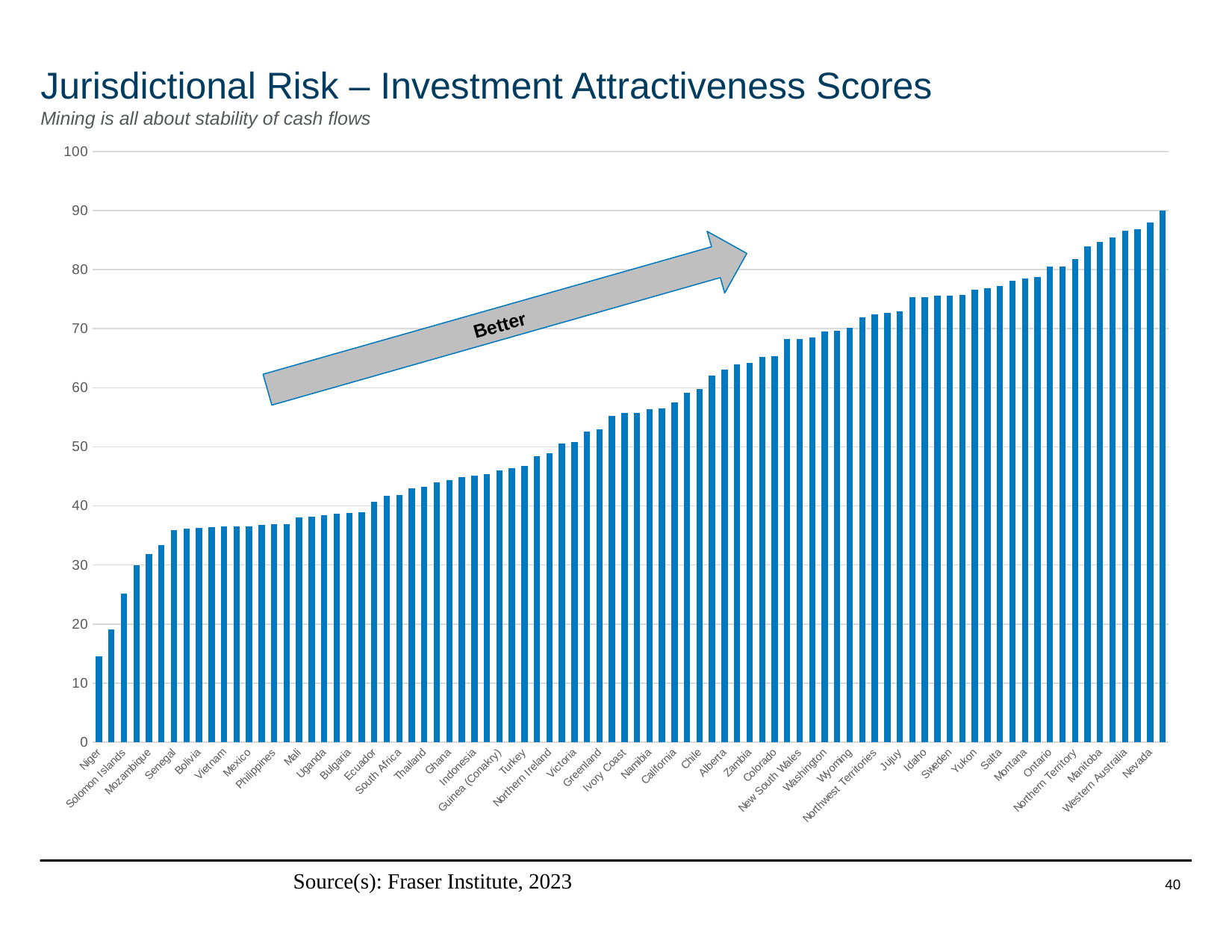
Which has a higher score, Alberta or Mexico? Alberta Is the value for Ghana greater or less than 50? less Is the value for Chile greater or less than 50? greater What is the title of the chart on the slide? Jurisdictional Risk – Investment Attractiveness Scores Which jurisdiction has the lowest investment attractiveness score? Niger What kind of chart is shown on the slide? bar chart Do the scores rise or fall moving from left to right along the x axis? rise Is the value for Solomon Islands greater or less than 30? less